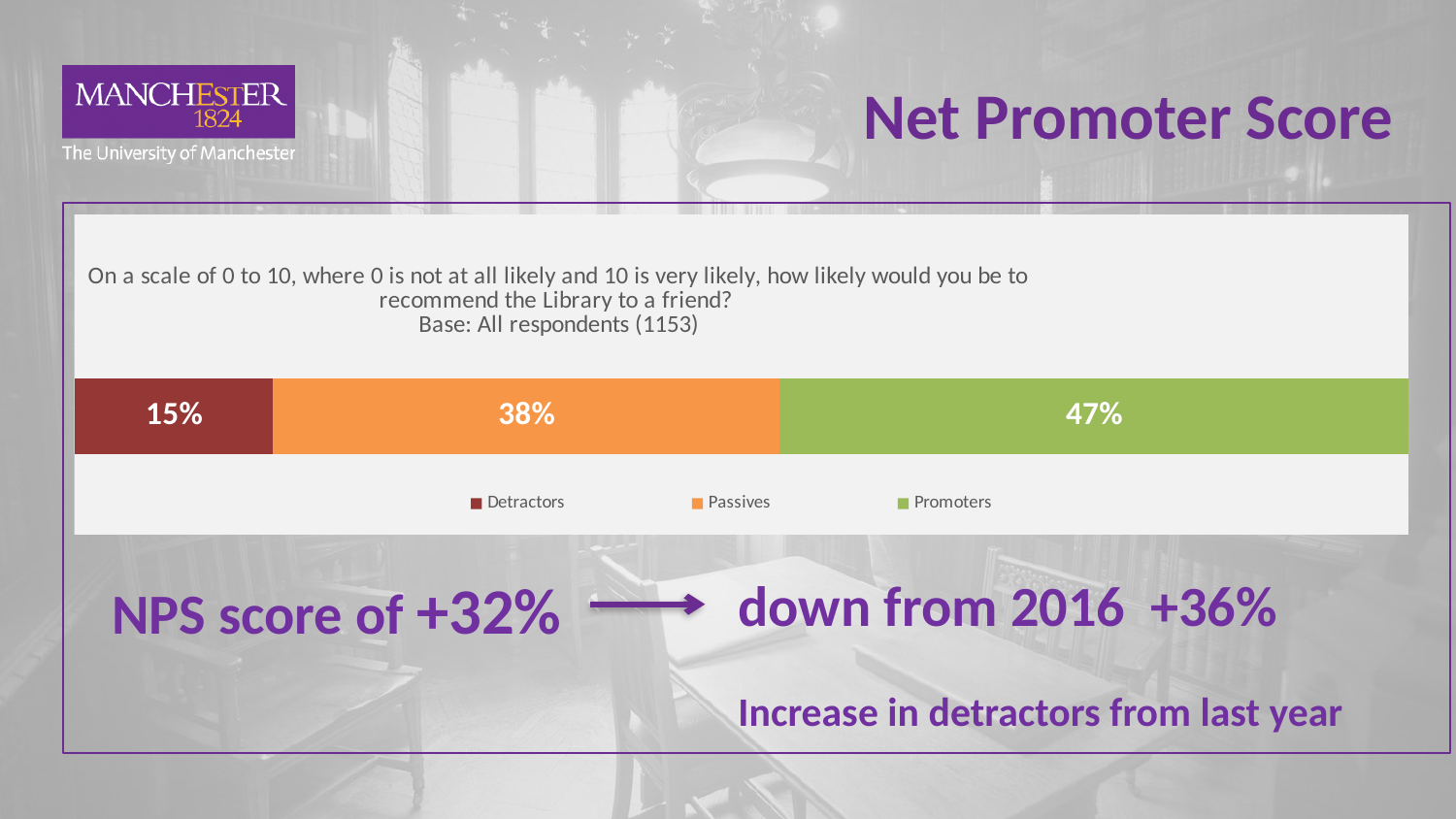
What percentage of respondents are Detractors? 15% What is the difference in percentage points between Promoters and Passives? 9 How many series does the legend list? 3 What is the total of the three segments in the stacked bar? 100% Which is larger, the share of Passives or the share of Detractors? Passives What colour represents Promoters in the chart? Green What kind of chart is shown on the slide? Stacked bar chart Which group has the largest share of respondents? Promoters What percentage of respondents are Passives? 38% Which group has the smallest share of respondents? Detractors What is the difference in percentage points between Promoters and Detractors? 32 What percentage of respondents are Promoters? 47%